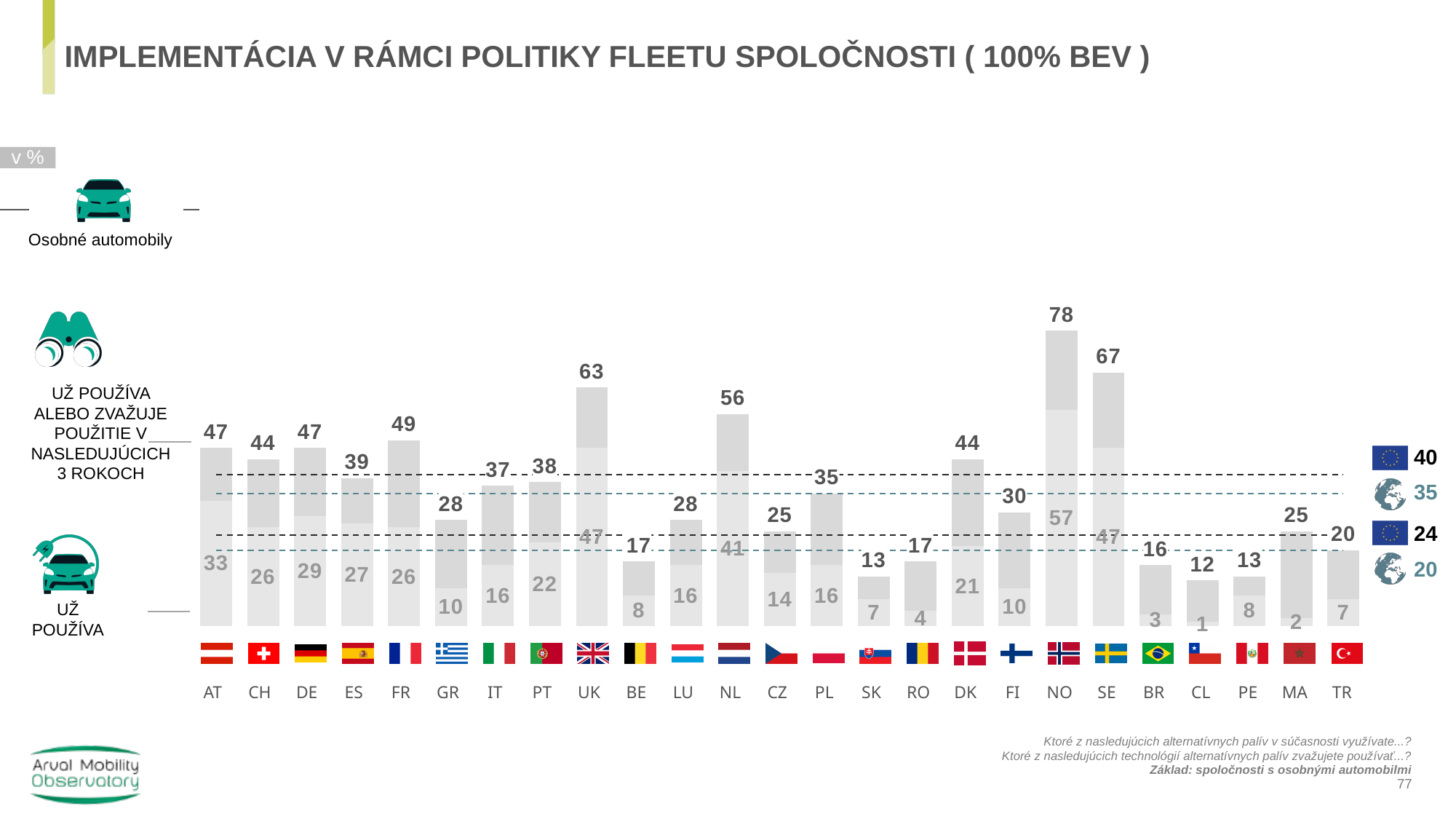
What is the difference between the 'už používa' values for AT and CH? 7 What is the difference between the 'už používa alebo zvažuje' values for SE and NL? 11 What is the global reference value shown for 'už používa' (lower dashed line)? 20 Which has a higher 'už používa' value, DE or ES? DE Which country has the lowest 'už používa' value? CL What type of chart is shown on the slide? bar chart What is the value for NO for 'už používa alebo zvažuje použitie v nasledujúcich 3 rokoch'? 78 What is the EU reference value shown for 'už používa alebo zvažuje použitie v nasledujúcich 3 rokoch' (upper dashed line)? 40 How many countries are shown on the x axis of the chart? 25 What is the 'už používa' value for RO? 4 Which country has the highest value for 'už používa alebo zvažuje použitie v nasledujúcich 3 rokoch'? NO What is the 'už používa' value for UK? 47